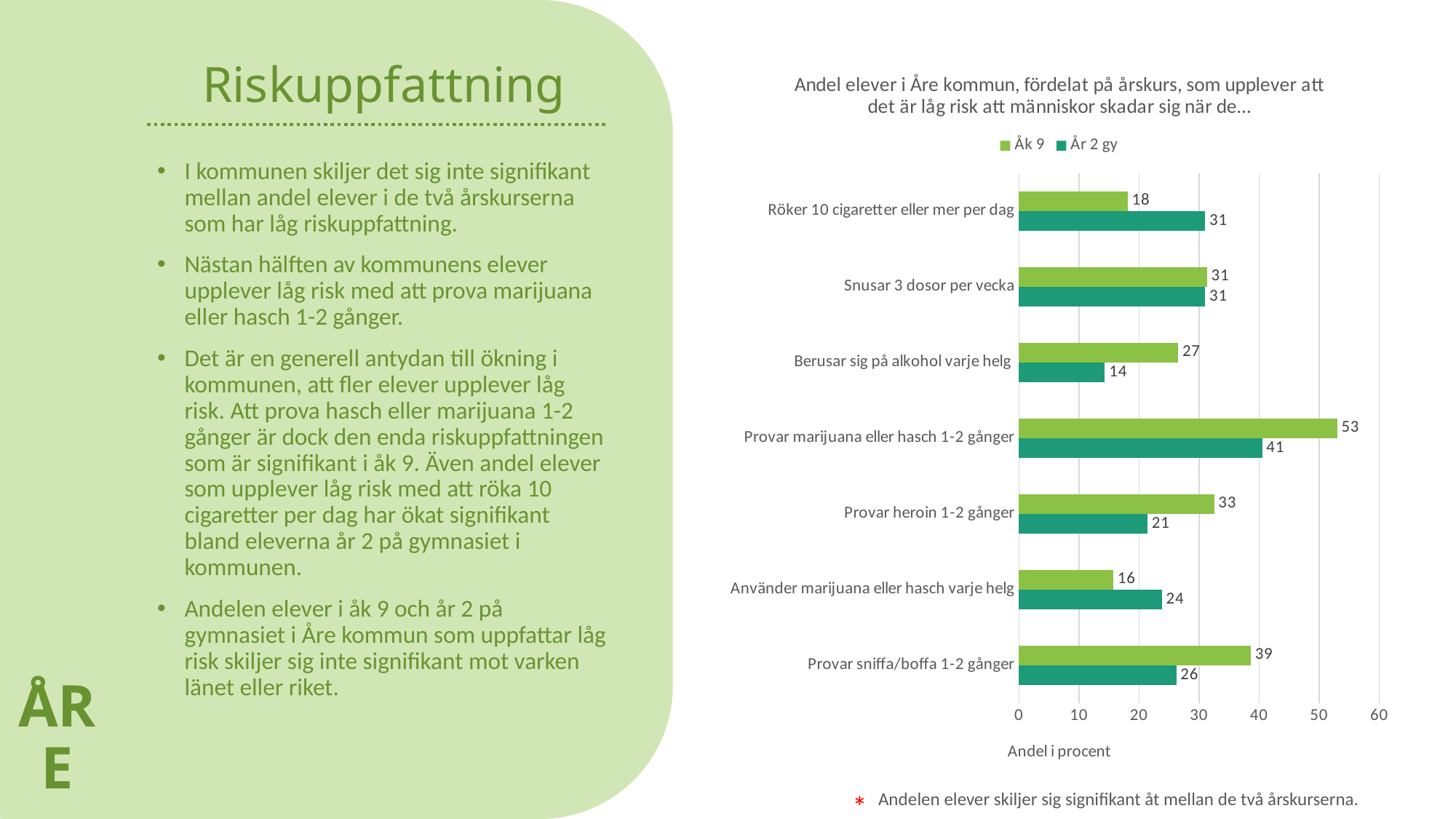
What is the difference between the Åk 9 and År 2 gy values for "Provar heroin 1-2 gånger"? 12 Which category has the lowest value for År 2 gy? Berusar sig på alkohol varje helg For "Använder marijuana eller hasch varje helg", which series has the larger value, Åk 9 or År 2 gy? År 2 gy What kind of chart is shown on the slide? Bar chart What is the label of the x axis? Andel i procent What is the value for År 2 gy for "Berusar sig på alkohol varje helg"? 14 Which category has the highest value for Åk 9? Provar marijuana eller hasch 1-2 gånger What is the value for Åk 9 for "Provar marijuana eller hasch 1-2 gånger"? 53 What is the value for År 2 gy for "Röker 10 cigaretter eller mer per dag"? 31 How many categories are shown on the chart? 7 How many series does the legend list? 2 What is the value for Åk 9 for "Provar sniffa/boffa 1-2 gånger"? 39